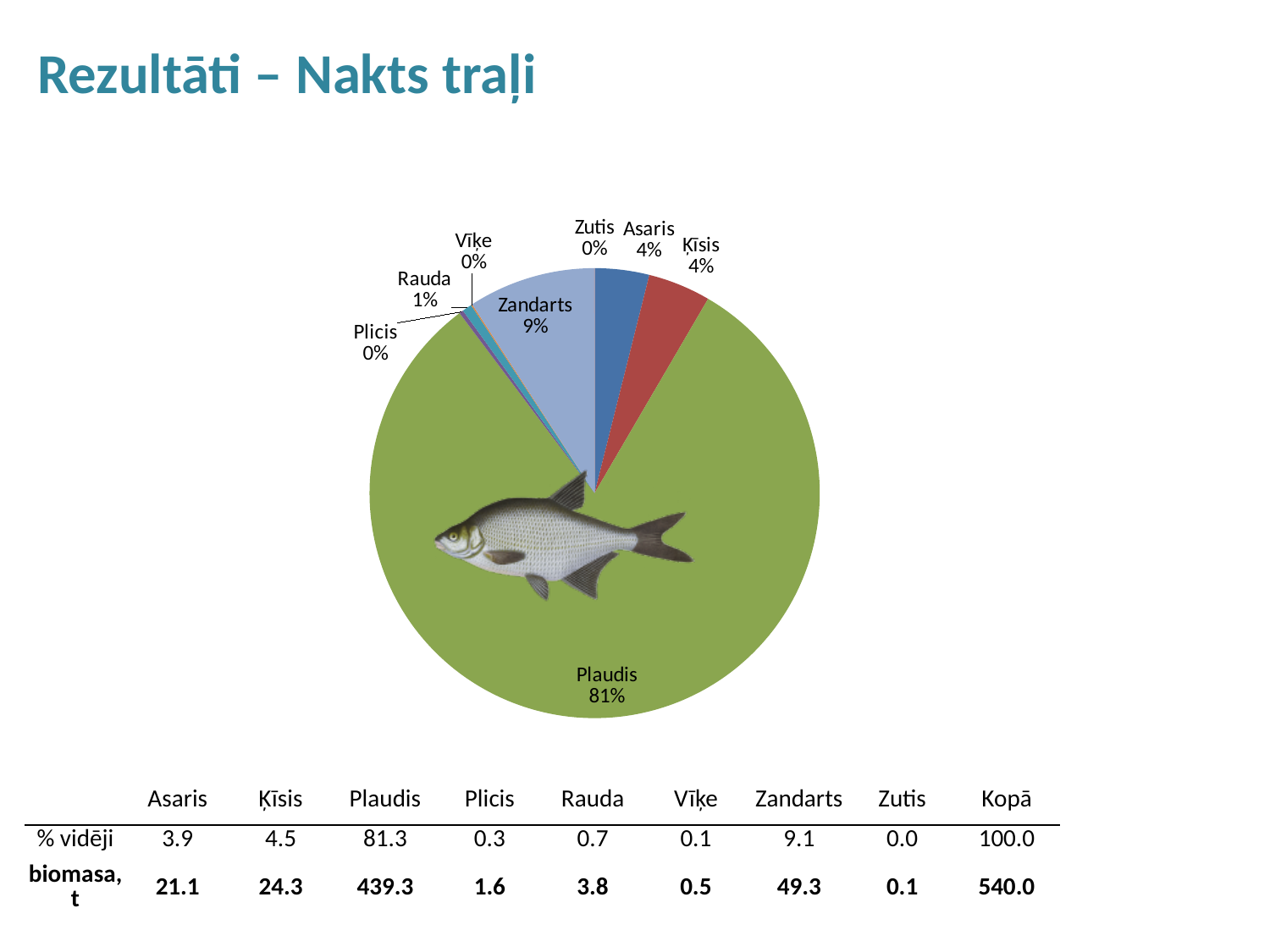
What is the title of the slide containing the pie chart? Rezultāti – Nakts traļi What share of the pie does Zandarts have? 9% What share of the pie does Plaudis have? 81% How many slices (categories) are labelled in the pie chart? 8 What percentage is shown for Asaris in the pie chart? 4% What colour is the Plaudis slice of the pie? green What type of chart is shown on the slide? pie chart Which slice is larger, Zandarts or Asaris? Zandarts What is the difference in percentage points between Plaudis and Zandarts? 72 What percentage is shown for Ķīsis in the pie chart? 4% Which category has the largest slice of the pie? Plaudis What percentage is shown for Rauda in the pie chart? 1%